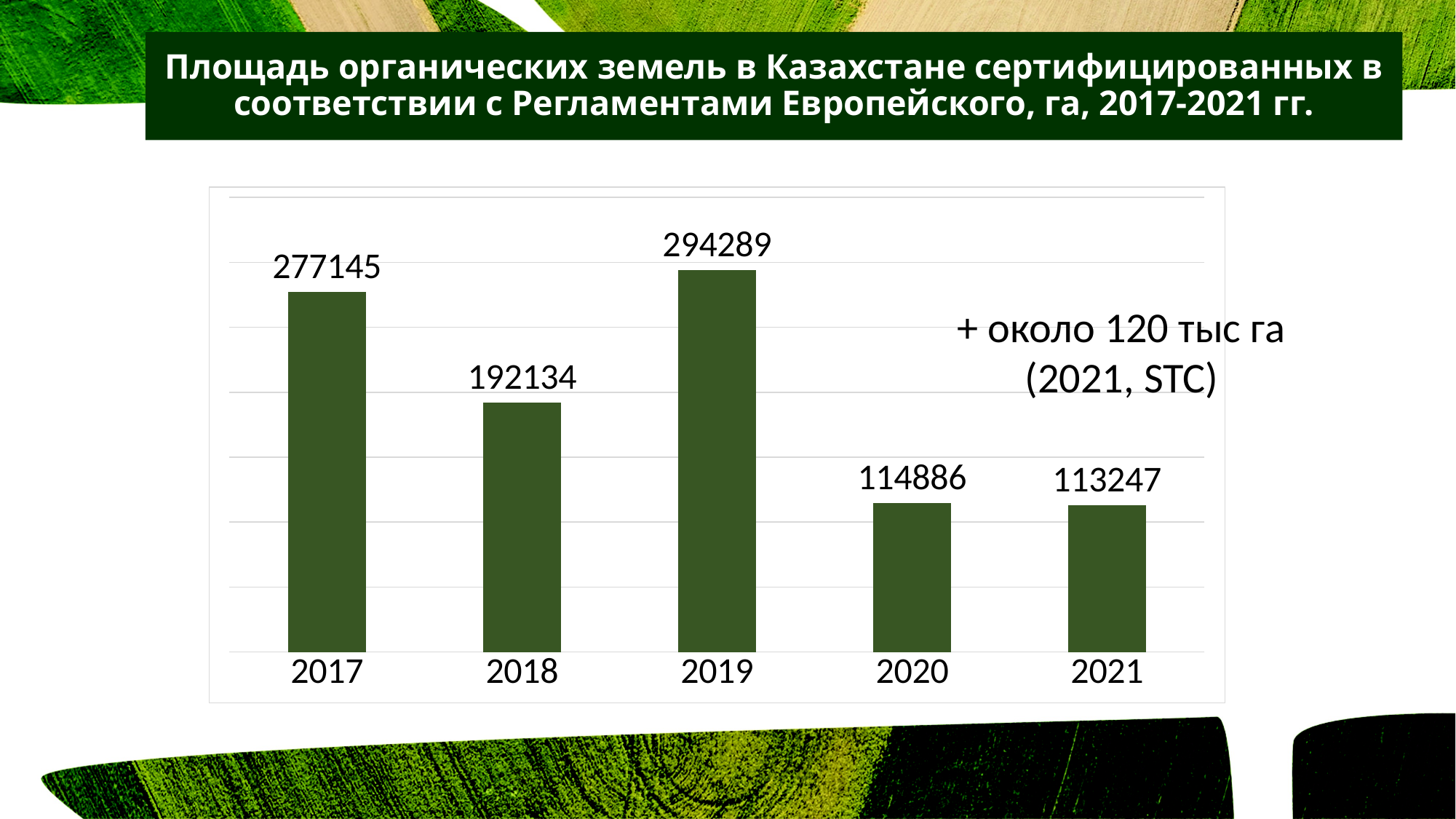
What is the difference between the values for 2019 and 2017? 17144 How many years (categories) are plotted in the chart? 5 Which is larger, the value for 2018 or the value for 2020? 2018 Which year has the lowest value? 2021 What is the value for 2018? 192134 Do the values rise or fall from 2019 to 2021? Fall Which year has the highest value? 2019 What is the difference between the values for 2020 and 2021? 1639 What is the value for 2021? 113247 What is the value for 2019? 294289 What type of chart is shown on the slide? Bar chart What is the value for 2017? 277145